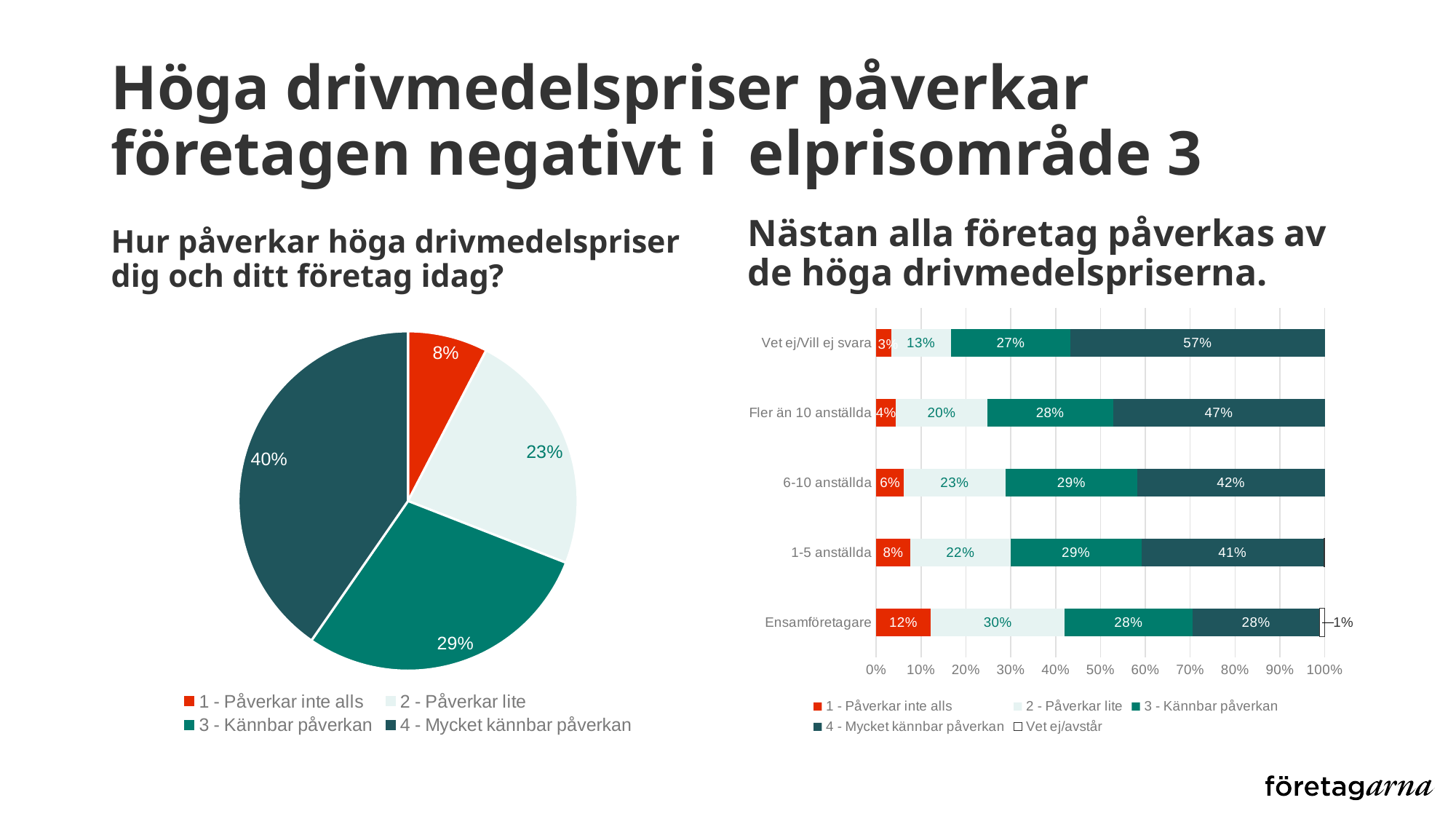
In the stacked bar chart on the right, what is the value of "4 - Mycket kännbar påverkan" for Vet ej/Vill ej svara? 57% In the pie chart on the left, what share of respondents answered "4 - Mycket kännbar påverkan"? 40% In the pie chart on the left, how many slices are there? 4 In the pie chart on the left, which answer has the smallest slice? 1 - Påverkar inte alls In the stacked bar chart on the right, how many series does the legend list? 5 In the stacked bar chart on the right, which category has the highest value for "4 - Mycket kännbar påverkan"? Vet ej/Vill ej svara In the stacked bar chart on the right, what is the difference between the "4 - Mycket kännbar påverkan" values for 6-10 anställda and 1-5 anställda? 1% In the pie chart on the left, which answer has the largest slice? 4 - Mycket kännbar påverkan In the pie chart on the left, what share of respondents answered "1 - Påverkar inte alls"? 8% In the stacked bar chart on the right, what is the value of "1 - Påverkar inte alls" for Ensamföretagare? 12% What kind of chart is shown on the right side of the slide? Stacked bar chart In the stacked bar chart on the right, what is the value of "2 - Påverkar lite" for Fler än 10 anställda? 20%